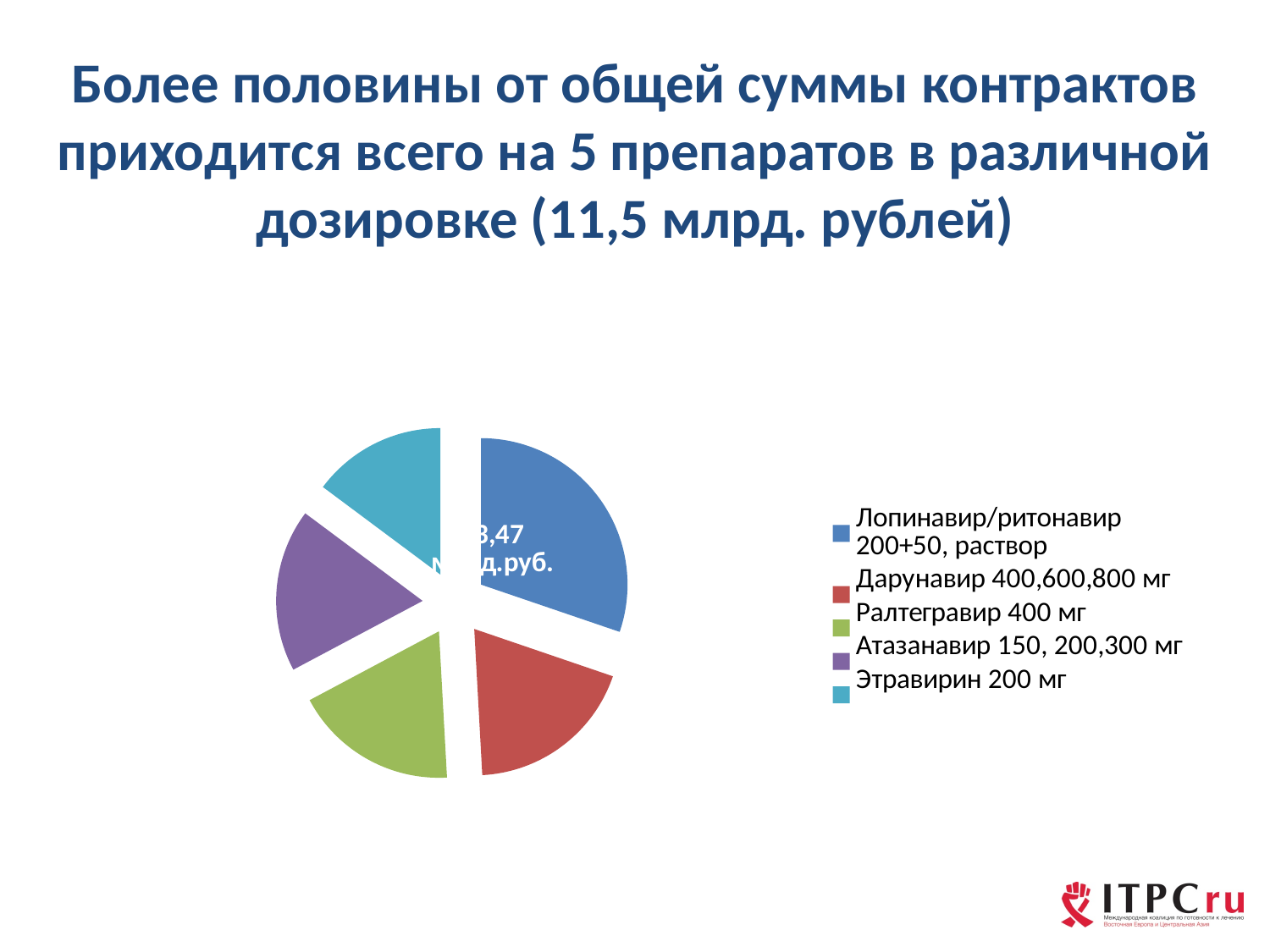
Which slice is larger: Лопинавир/ритонавир 200+50, раствор or Ралтегравир 400 мг? Лопинавир/ритонавир 200+50, раствор How many slices does the pie chart have? 5 How many entries does the legend list? 5 Which colour represents Дарунавир 400,600,800 мг in the legend? red What value is printed on the slice for Лопинавир/ритонавир 200+50, раствор? 3,47 млрд.руб. Which drug has the largest slice of the pie? Лопинавир/ритонавир 200+50, раствор Which slice is larger: Лопинавир/ритонавир 200+50, раствор or Этравирин 200 мг? Лопинавир/ритонавир 200+50, раствор Which legend entry is shown in purple? Атазанавир 150, 200,300 мг What kind of chart is shown on the slide? pie chart